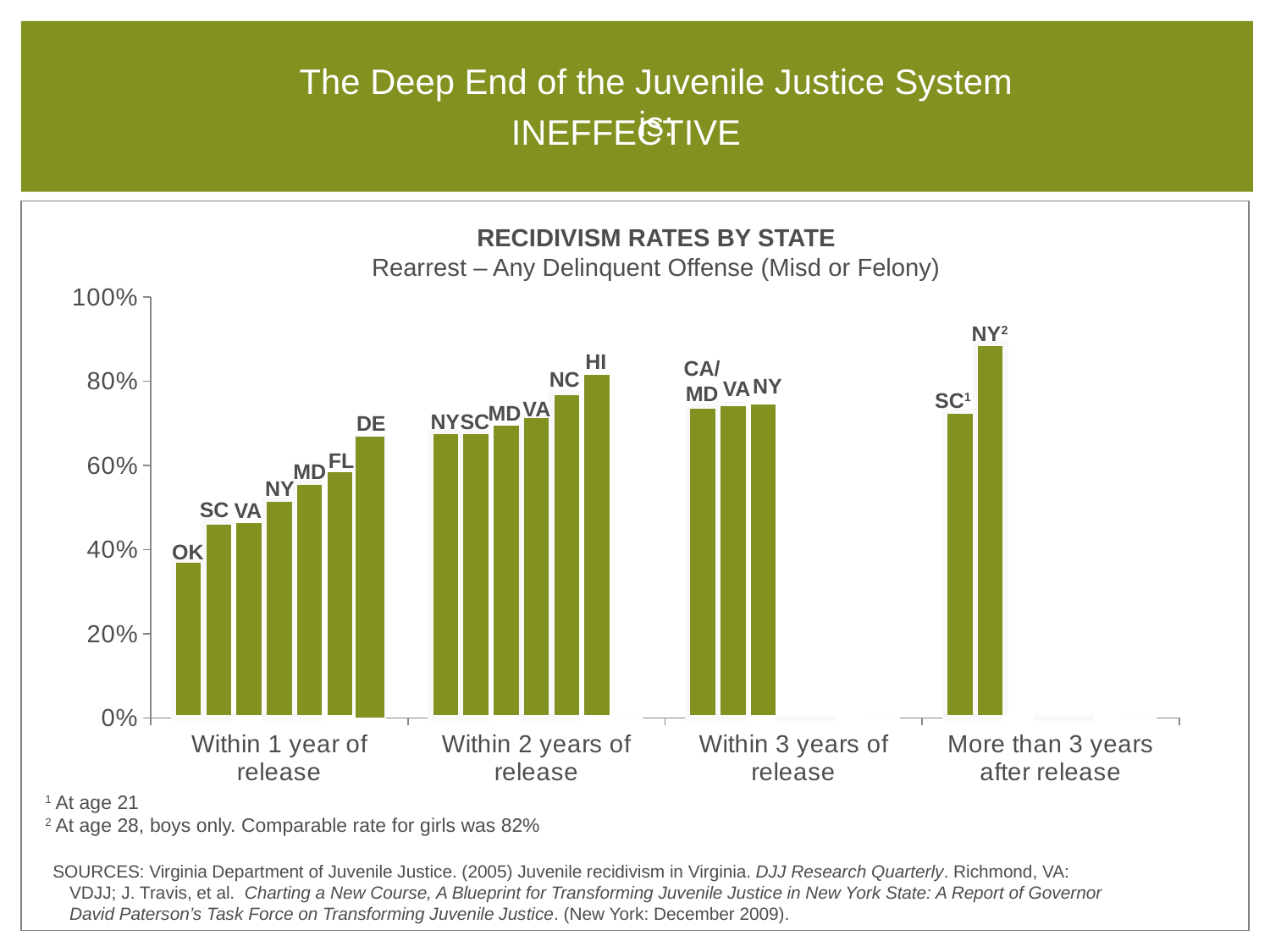
Which state has the highest recidivism rate in the 'Within 2 years of release' group? HI How many state bars are in the 'Within 2 years of release' group? 6 Which state has the highest recidivism rate in the 'Within 1 year of release' group? DE Which state has the lowest recidivism rate in the 'Within 1 year of release' group? OK What kind of chart is shown on the slide? bar chart Is the value for OK in the 'Within 1 year of release' group greater or less than 40%? less Is the value for HI in the 'Within 2 years of release' group greater or less than 80%? greater Do the bars in the 'Within 1 year of release' group rise or fall from left to right? rise What is the title of the chart? RECIDIVISM RATES BY STATE How many state bars are in the 'Within 1 year of release' group? 7 In the 'More than 3 years after release' group, which bar is taller, SC or NY? NY How many time-period groups are shown along the x axis? 4